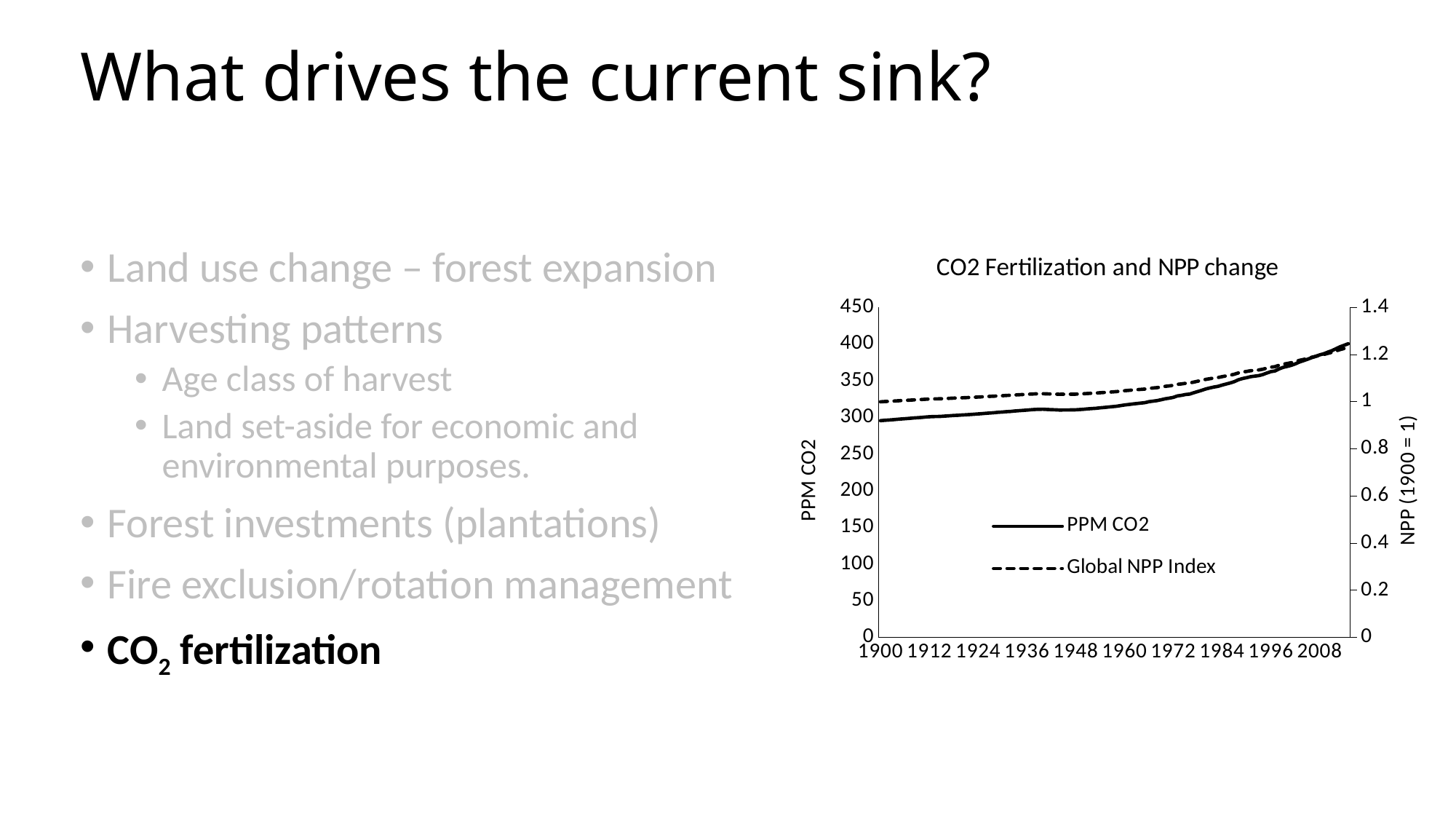
Is the value for PPM CO2 in 1900 greater or less than 350? less What kind of chart is shown on the slide? line chart How many year labels are shown along the x axis of the chart? 10 Is the value for PPM CO2 in 2008 greater or less than 350? greater Does the PPM CO2 series rise or fall from 1900 to 2008? rise What is the title of the chart? CO2 Fertilization and NPP change Is the value for the Global NPP Index in 1900 greater or less than 1.2? less What is the first year shown on the chart's x axis? 1900 Which series is drawn with a dashed line in the chart? Global NPP Index Does the Global NPP Index series rise or fall across the x axis? rise How many series does the chart's legend list? 2